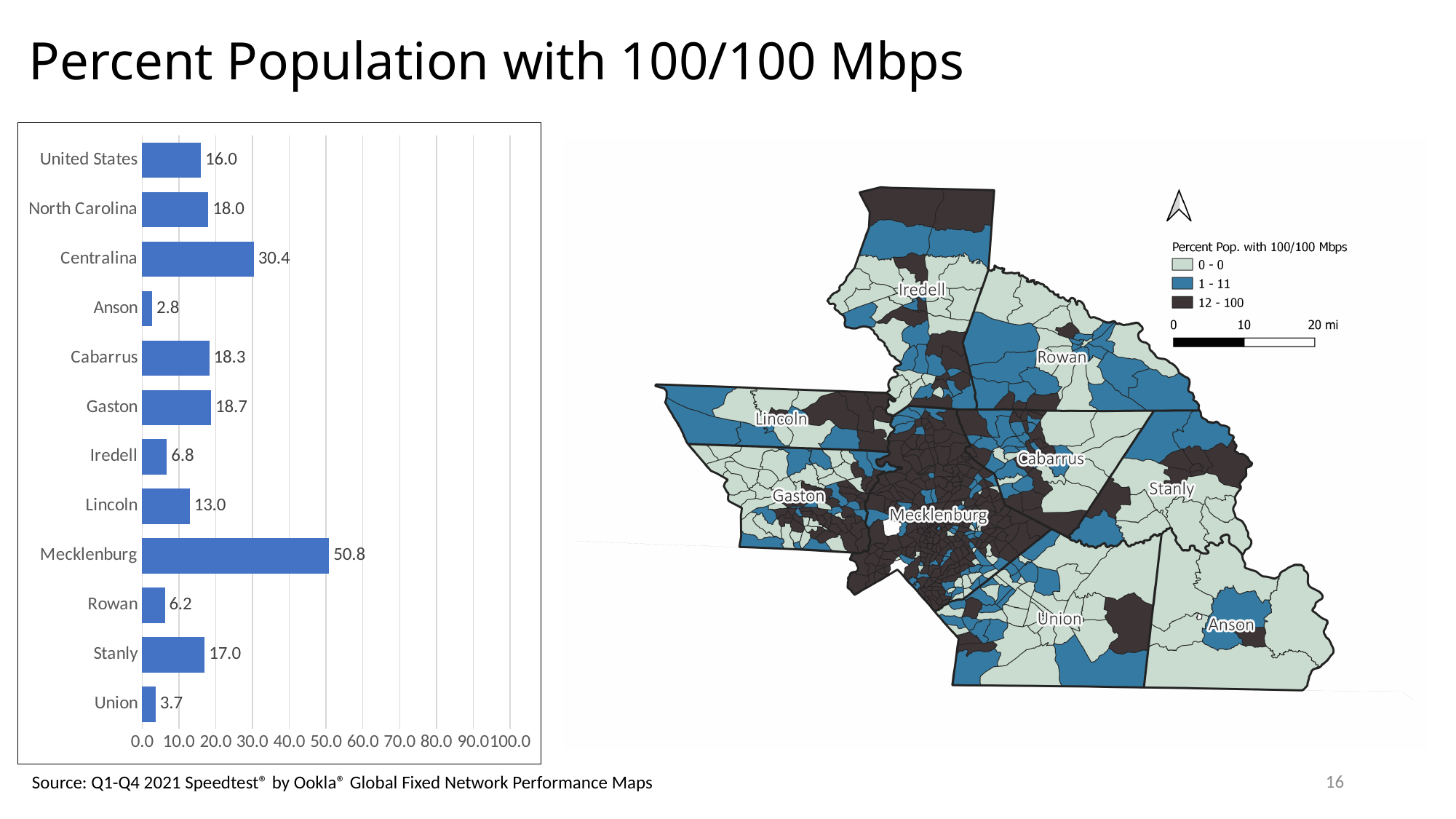
What is the value for Centralina in the bar chart? 30.4 Which has a larger value in the bar chart, Gaston or Cabarrus? Gaston Which category has the lowest value in the bar chart? Anson Which category has the highest value in the bar chart? Mecklenburg What is the difference between the values for North Carolina and the United States in the bar chart? 2.0 What is the difference between the values for Mecklenburg and Centralina in the bar chart? 20.4 What kind of chart is shown on the left of the slide? Bar chart What is the value for North Carolina in the bar chart? 18.0 Which has a larger value in the bar chart, Stanly or Lincoln? Stanly What is the value for Mecklenburg in the bar chart? 50.8 How many categories are shown in the bar chart? 12 What is the value for Union in the bar chart? 3.7